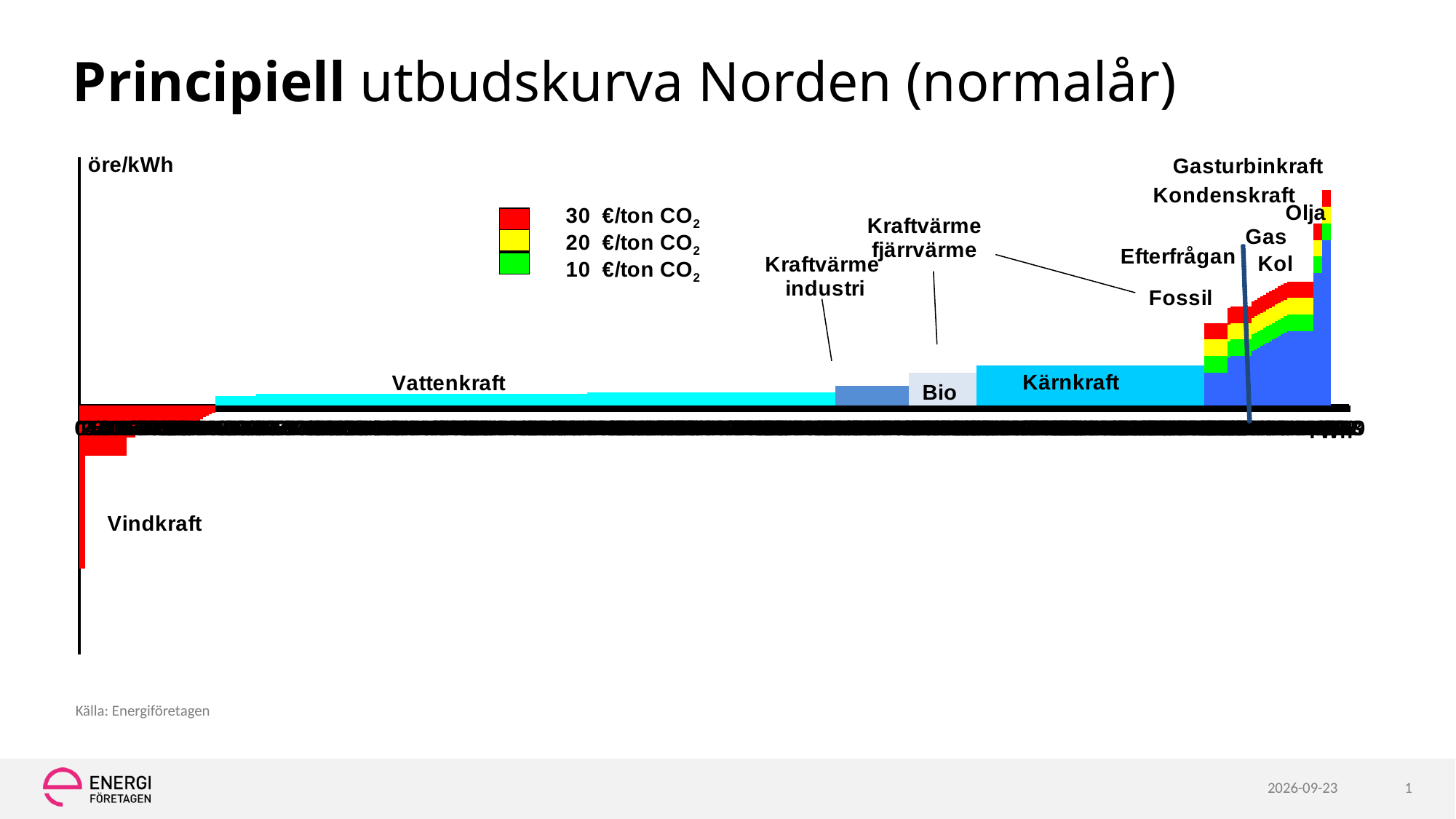
What unit is shown on the vertical axis of the chart? öre/kWh Is Kärnkraft plotted higher or lower on the curve than Vattenkraft? Higher Which colour in the legend represents 30 €/ton CO2? Red Is Bio plotted higher or lower on the curve than Kärnkraft? Lower Is Kol plotted higher or lower on the curve than Olja? Lower Which technology is at the highest point of the supply curve? Gasturbinkraft Which technology is plotted below the horizontal axis, with a negative value? Vindkraft How many CO2 price levels does the legend list? 3 Do the values of the supply curve rise or fall from left to right? Rise